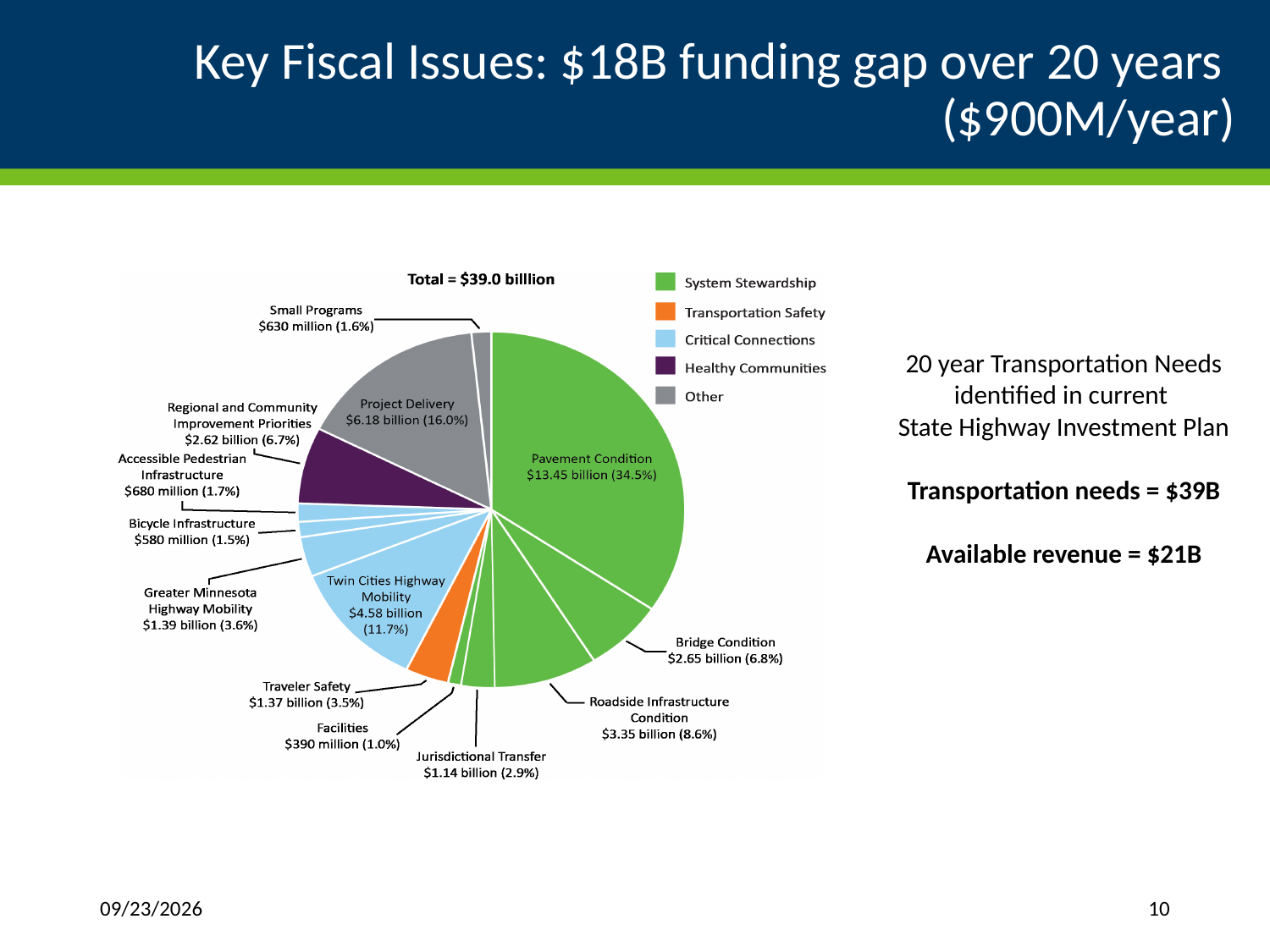
What total is stated above the pie chart? $39.0 billion What share of the pie does Project Delivery represent? 16.0% What share of the pie does Bridge Condition represent? 6.8% What kind of chart is shown on the slide? pie chart How many categories does the legend list? 5 How many slices does the pie chart have? 13 Which is larger, Roadside Infrastructure Condition or Bridge Condition? Roadside Infrastructure Condition Which slice of the pie is the smallest? Facilities What is the value shown for Twin Cities Highway Mobility? $4.58 billion Which slice of the pie is the largest? Pavement Condition What is the difference in percentage share between Pavement Condition and Project Delivery? 18.5% What is the value shown for Pavement Condition? $13.45 billion